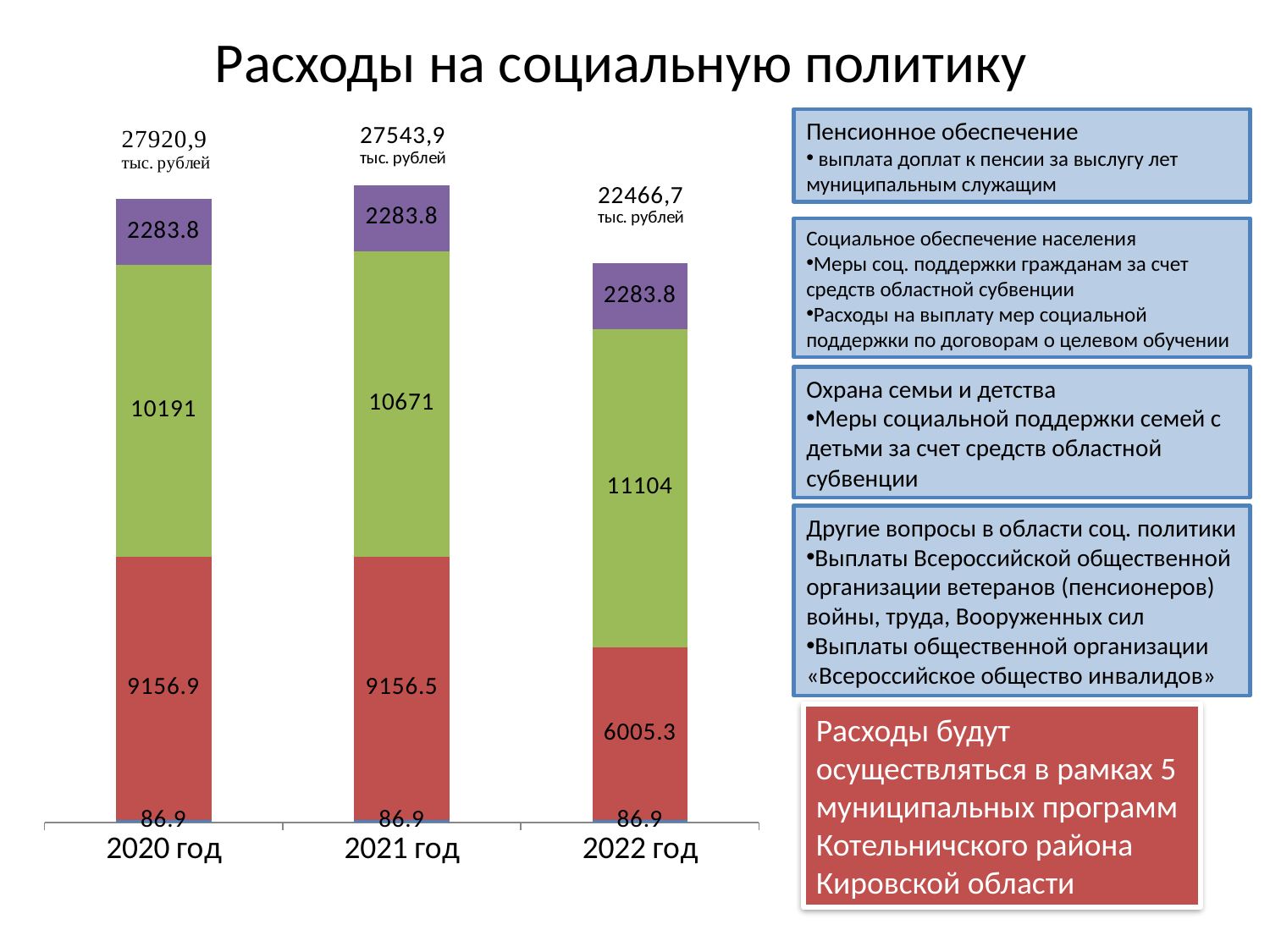
Does the value of the green segment rise or fall from 2020 год to 2022 год? rises What kind of chart is shown on the slide? stacked bar chart What is the value of the red segment for 2022 год? 6005.3 What is the value of the purple segment for 2022 год? 2283.8 What is the value of the green segment for 2021 год? 10671 Which year has the larger red segment, 2020 год or 2022 год? 2020 год Which year has the largest green segment? 2022 год Which year has the lowest total printed above its bar? 2022 год How many years (categories) are shown on the x axis of the chart? 3 What is the value of the smallest segment at the bottom of the 2021 год bar? 86.9 By how much does the green segment for 2022 год exceed the green segment for 2020 год? 913 What total is printed above the bar for 2020 год? 27920,9 тыс. рублей